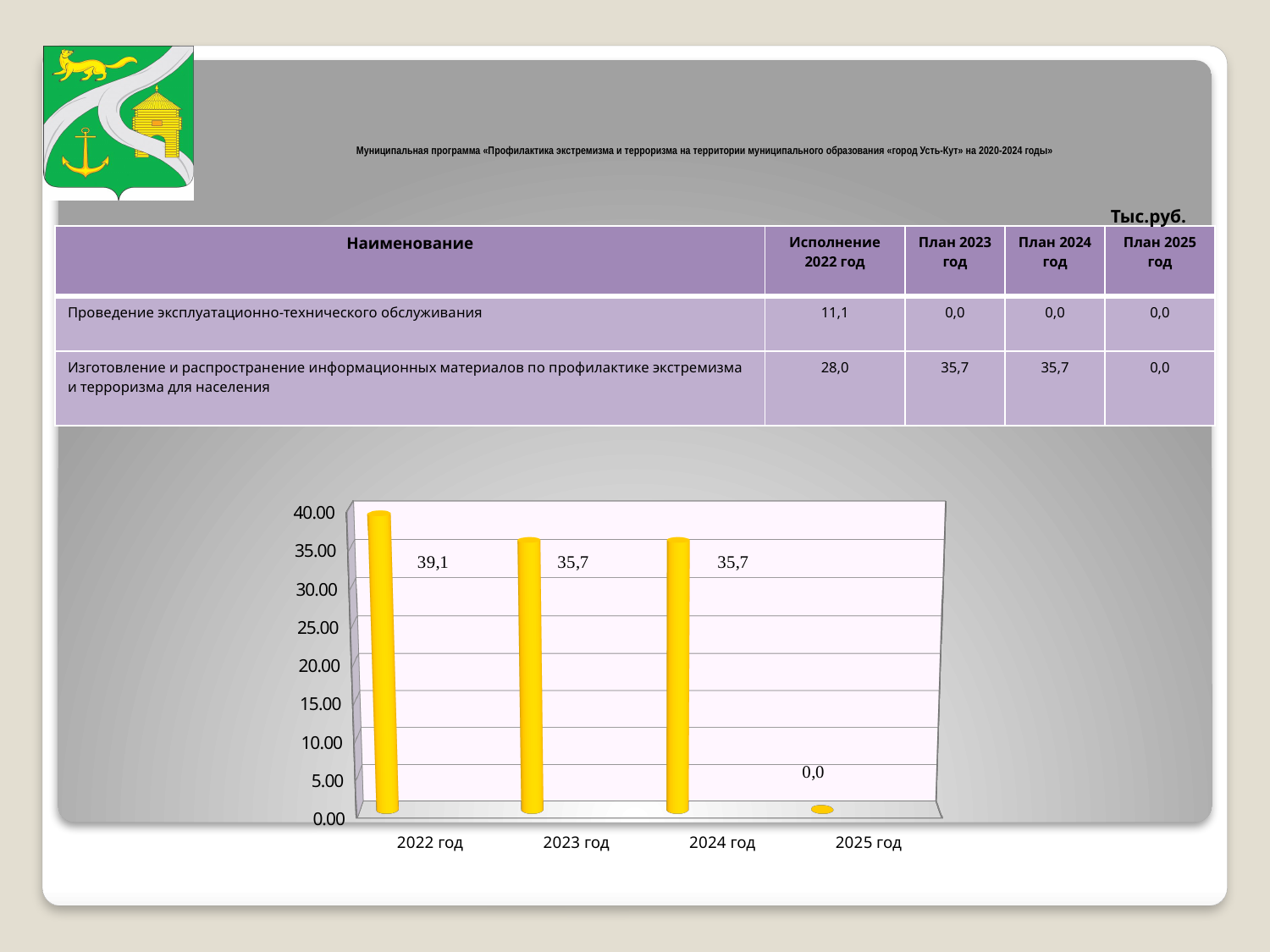
What is the difference between the values for 2022 год and 2023 год in the chart? 3,4 What kind of chart is shown on the slide? bar chart What is the value shown for 2024 год in the chart? 35,7 Do the values in the chart rise or fall from 2022 год to 2025 год? fall What is the value shown for 2025 год in the chart? 0,0 What is the value shown for 2023 год in the chart? 35,7 Which year has the lowest value in the chart? 2025 год Which year has the highest value in the chart? 2022 год Is the value for 2023 год in the chart greater or less than 30.00? greater Which is larger in the chart, the value for 2022 год or the value for 2024 год? 2022 год How many categories (years) are shown on the x axis of the chart? 4 What is the value shown for 2022 год in the chart? 39,1